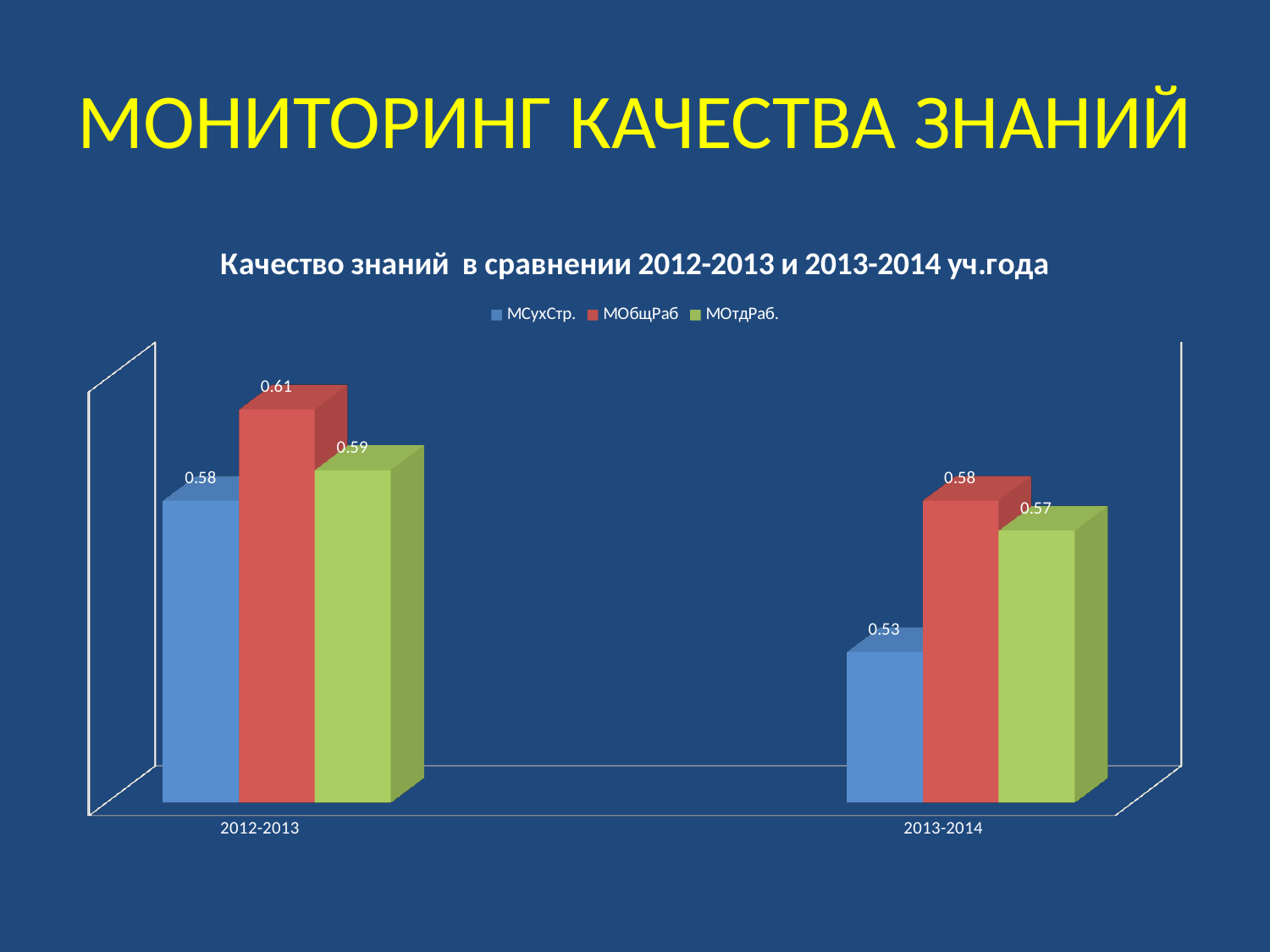
What is the value for МОтдРаб. in 2012-2013? 0.59 What kind of chart is shown on the slide? Bar chart What is the value for МСухСтр. in 2012-2013? 0.58 Which series has the highest value in 2012-2013? МОбщРаб How many series does the legend list? 3 What is the difference between the МОбщРаб values for 2012-2013 and 2013-2014? 0.03 What is the value for МСухСтр. in 2013-2014? 0.53 How many categories are shown on the x axis? 2 Which is larger: МОтдРаб. in 2012-2013 or МОтдРаб. in 2013-2014? МОтдРаб. in 2012-2013 Which series has the lowest value in 2013-2014? МСухСтр. Do the МСухСтр. values rise or fall from 2012-2013 to 2013-2014? Fall What is the value for МОбщРаб in 2013-2014? 0.58